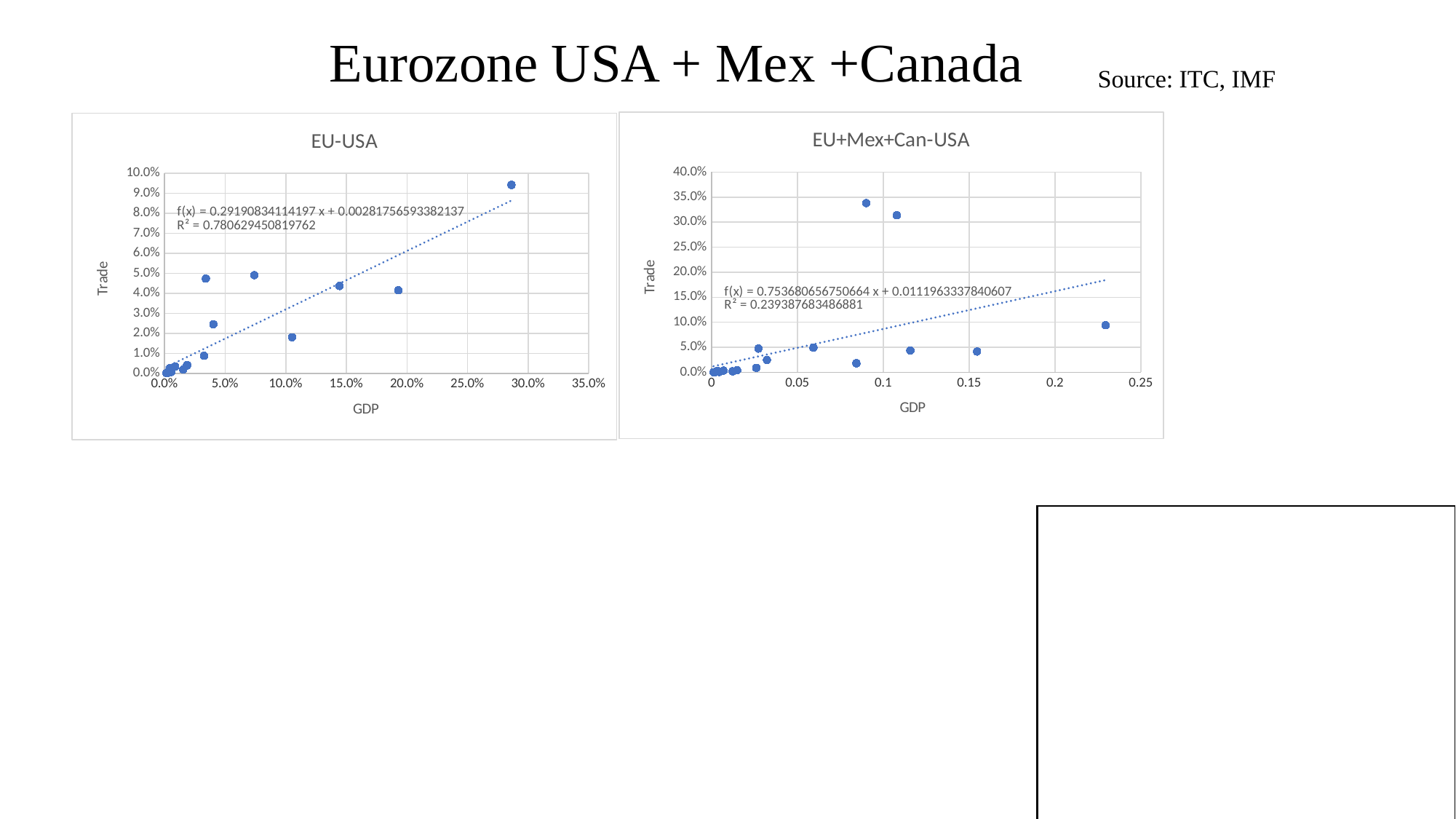
In the EU+Mex+Can-USA chart, is the Trade value of the highest point greater or less than 30.0%? greater What is the R² value shown on the EU+Mex+Can-USA chart? 0.239387683486881 In the EU+Mex+Can-USA chart, is the GDP value of the rightmost point greater or less than 0.2? greater In the EU-USA chart, is the Trade value of the highest point greater or less than 9.0%? greater What is the trendline equation shown on the EU+Mex+Can-USA chart? f(x) = 0.753680656750664 x + 0.0111963337840607 What is the trendline equation shown on the EU-USA chart? f(x) = 0.29190834114197 x + 0.00281756593382137 What is the R² value shown on the EU-USA chart? 0.780629450819762 What kind of chart is the EU-USA chart? scatter chart What is the label on the vertical axis of the EU+Mex+Can-USA chart? Trade Which chart has the higher R² value, EU-USA or EU+Mex+Can-USA? EU-USA In the EU-USA chart, does the dotted trendline rise or fall as GDP increases? rises